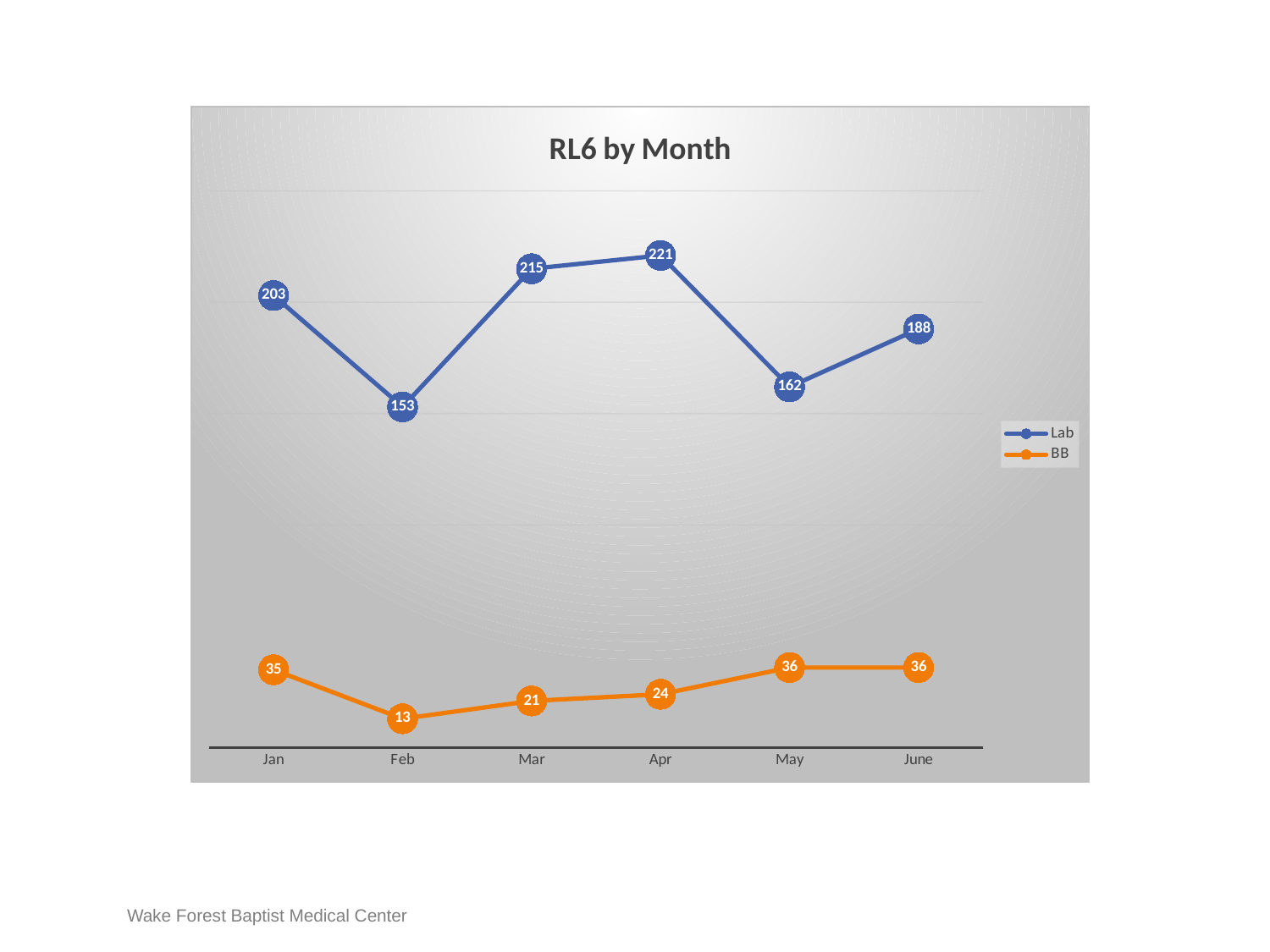
Which is larger, the BB value for Jan or the BB value for Apr? Jan What kind of chart is shown? line chart How many months are plotted on the x axis? 6 What is the title of the chart? RL6 by Month What is the difference between the Lab values for Mar and Feb? 62 What is the Lab value for Apr? 221 Which month has the highest Lab value? Apr What is the BB value for Feb? 13 Which month has the lowest BB value? Feb What is the Lab value for June? 188 How many series does the legend list? 2 Does the BB series rise or fall from Feb to May? rise